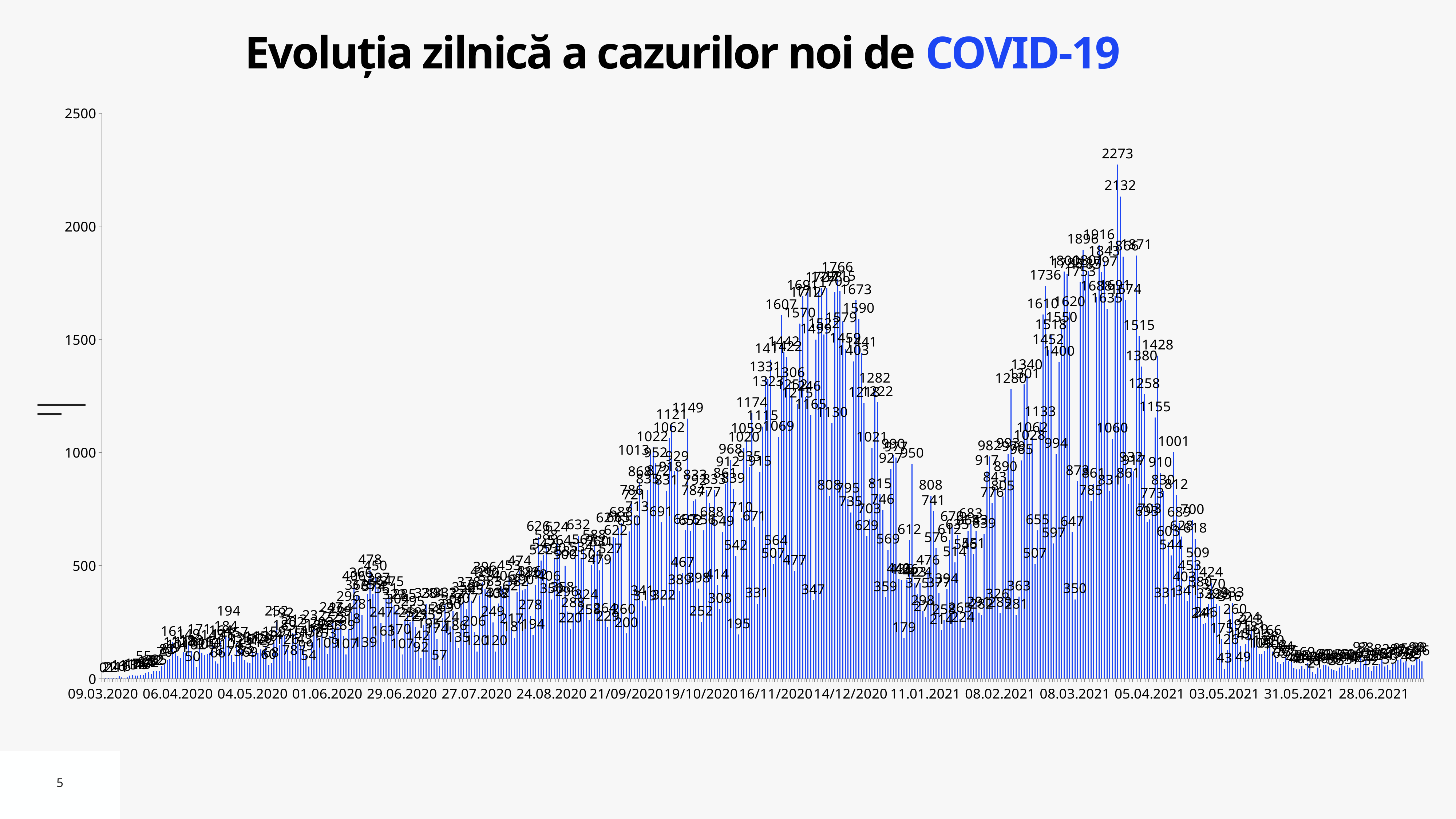
What is the highest labeled value in the wave around 14/12/2020? 1766 What is the difference between the two highest labeled values, 2273 and 2132? 141 Which is larger, the peak labeled 2273 or the bar labeled 2132? 2273 What is the title of the chart? Evoluția zilnică a cazurilor noi de COVID-19 Do the values rise or fall between 09.03.2020 and 06.04.2020? rise What kind of chart is shown on the slide? bar chart Is the highest bar on the chart greater or less than 2000? greater Are the bars near 09.03.2020 greater or less than 500? less What is the highest daily value labeled on the chart? 2273 What is the second highest daily value labeled on the chart, next to the 2273 peak? 2132 Do the values rise or fall between 05.04.2021 and 31.05.2021? fall What is the maximum value shown on the vertical axis? 2500